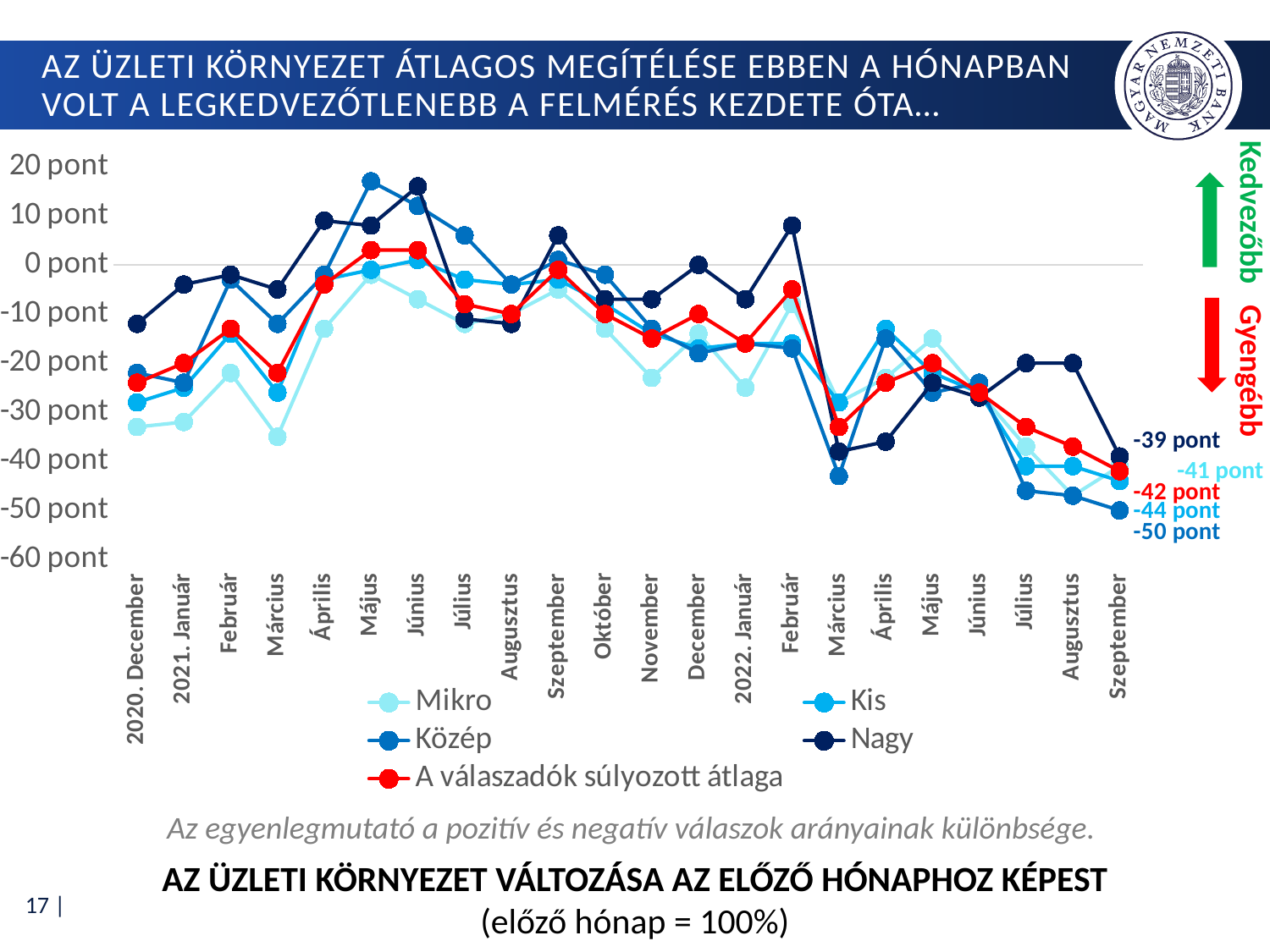
Which series has the lowest value in Szeptember 2022? Közép What kind of chart is shown on the slide? line chart How many months are plotted along the x axis? 22 What is the value for Nagy in Szeptember 2022, as labelled at the end of the line? -39 pont What is the value for Közép in Szeptember 2022, as labelled at the end of the line? -50 pont What is the value for A válaszadók súlyozott átlaga in Szeptember 2022, as labelled at the end of the line? -42 pont What colour is the line for A válaszadók súlyozott átlaga? red What is the difference between the Nagy and Közép values in Szeptember 2022? 11 pont In Szeptember 2022, which is higher: Nagy or Közép? Nagy Is the value for Nagy in Május 2021 greater or less than 10 pont? less How many series does the legend list? 5 Is the value for Mikro in Március 2021 greater or less than -30 pont? less